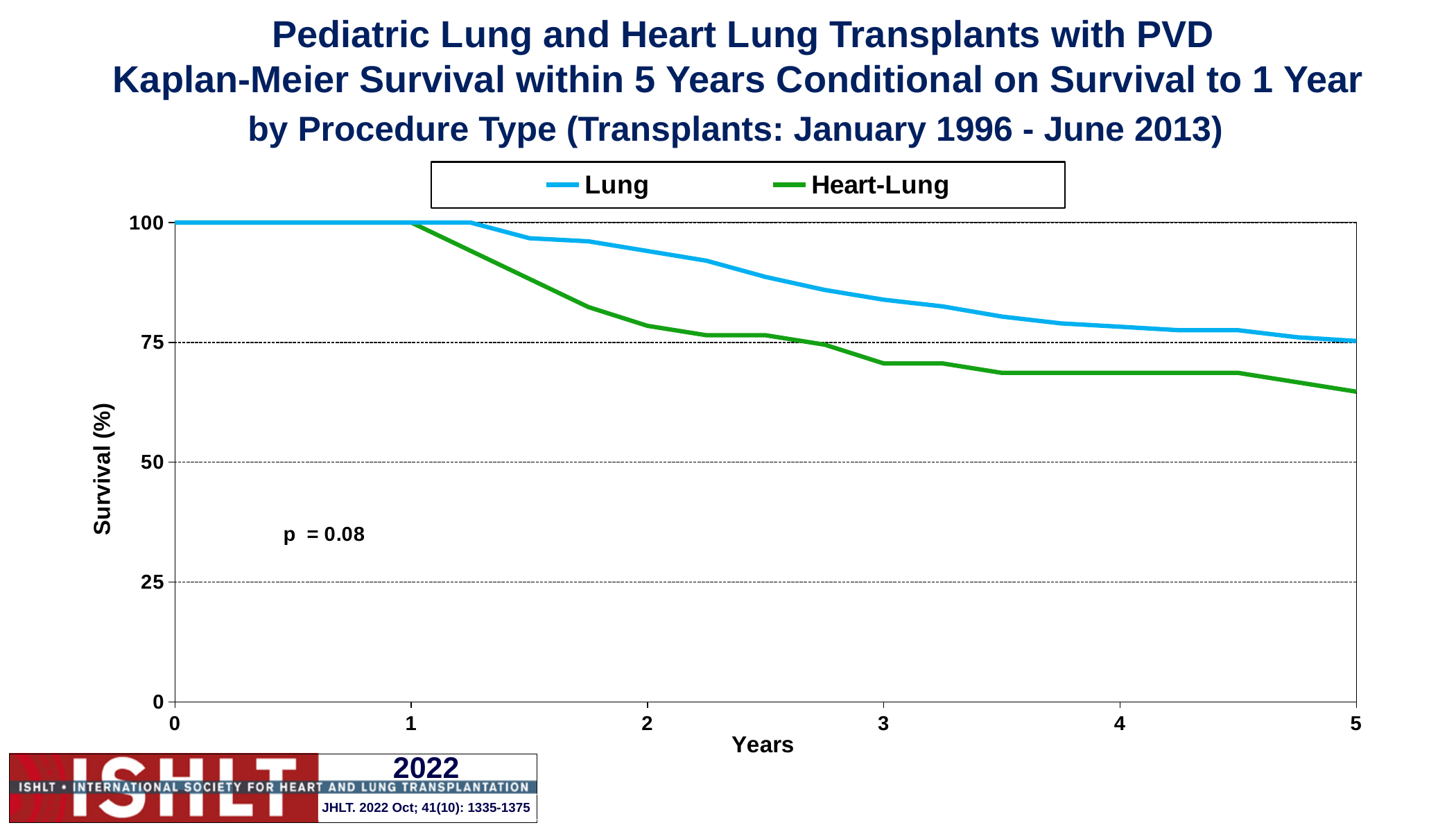
What p-value is printed on the chart? p = 0.08 Is the survival value for Heart-Lung at year 5 greater or less than 75? less How many series does the legend list? 2 At year 5, which series has the higher survival, Lung or Heart-Lung? Lung What is the survival (%) for Heart-Lung at year 1? 100 Is the survival value for Heart-Lung at year 3 greater or less than 75? less Do the survival values rise or fall as years increase? fall What are the two series named in the legend? Lung and Heart-Lung What is the survival (%) for Lung at year 0? 100 Is the survival value for Lung at year 3 greater or less than 75? greater At year 2, which series has the higher survival, Lung or Heart-Lung? Lung What kind of chart is shown on the slide? line chart